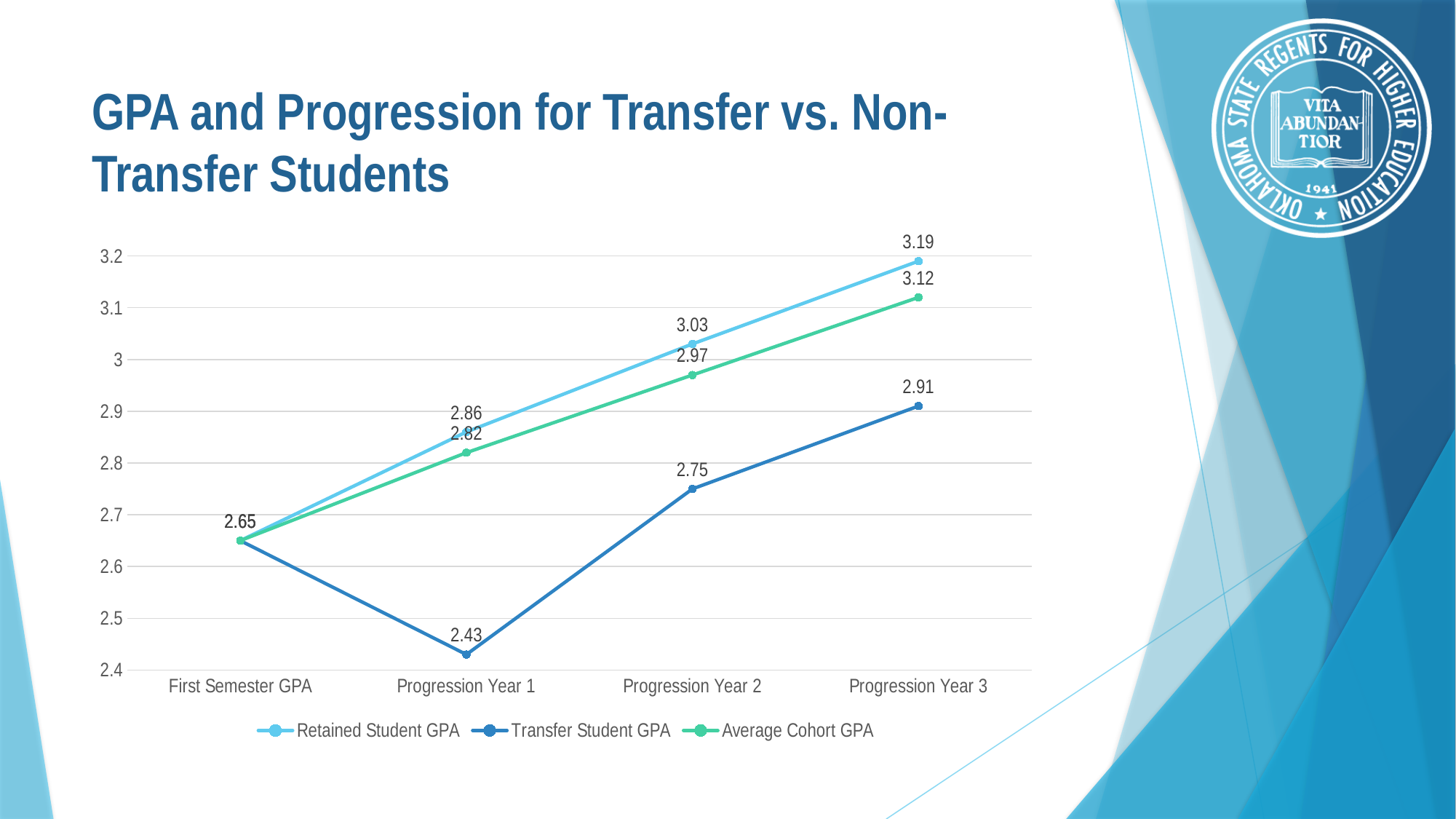
At which category is the Transfer Student GPA lowest? Progression Year 1 Does the Retained Student GPA rise or fall from First Semester GPA to Progression Year 3? rise What is the title of the slide? GPA and Progression for Transfer vs. Non-Transfer Students How many categories are shown on the x axis? 4 What is the Transfer Student GPA at Progression Year 1? 2.43 How many series does the legend list? 3 What is the Average Cohort GPA at Progression Year 2? 2.97 At which category is the Retained Student GPA highest? Progression Year 3 What kind of chart is shown on the slide? line chart What is the Retained Student GPA at Progression Year 3? 3.19 Which is larger at Progression Year 2: the Retained Student GPA or the Transfer Student GPA? Retained Student GPA What is the difference between the Retained Student GPA and the Transfer Student GPA at Progression Year 3? 0.28